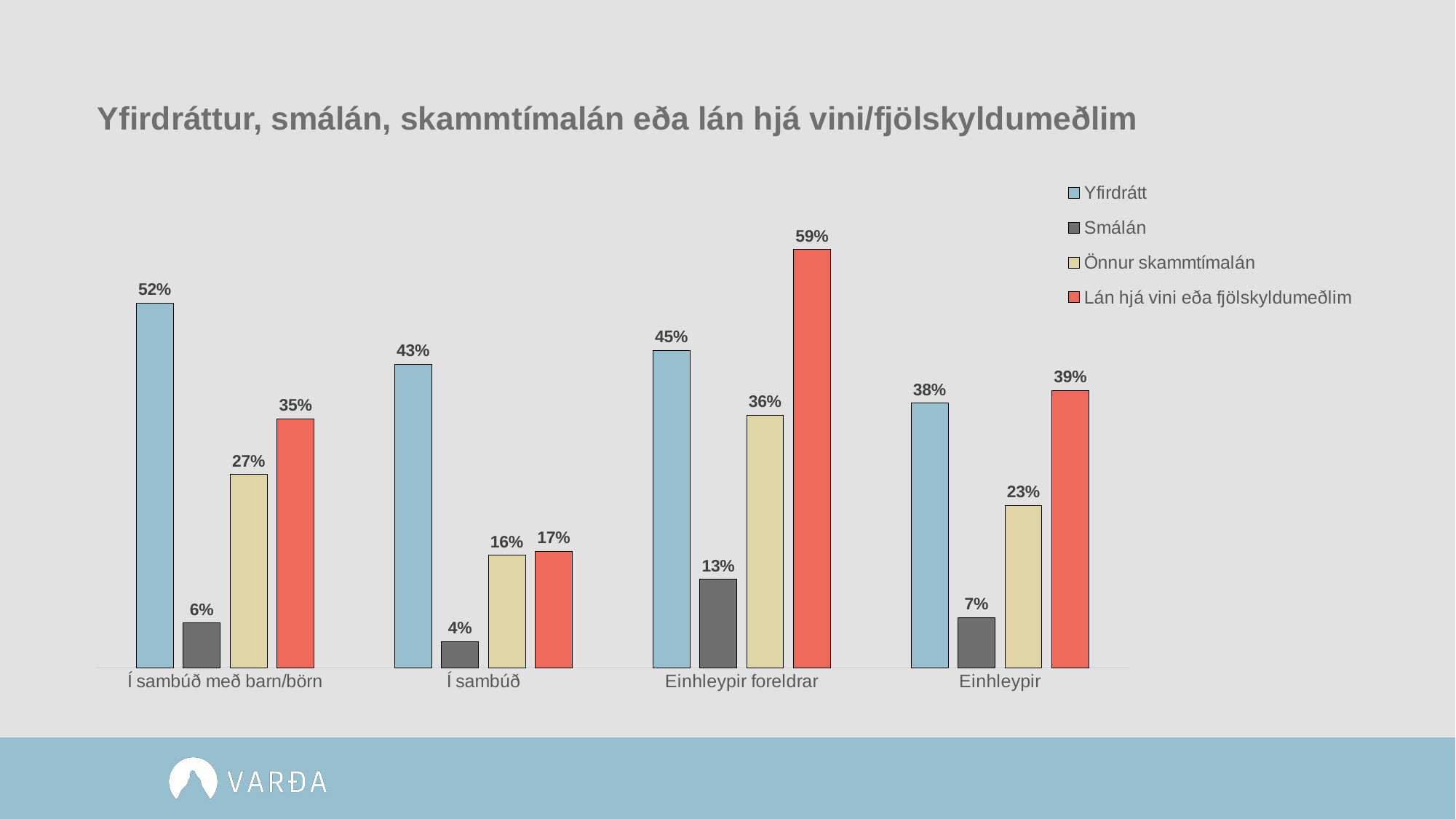
How many series does the legend list? 4 What is the value for Lán hjá vini eða fjölskyldumeðlim in the Einhleypir foreldrar category? 59% How many categories are shown on the x axis? 4 What is the value for Yfirdrátt in the Í sambúð með barn/börn category? 52% What is the value for Önnur skammtímalán in the Einhleypir category? 23% Which is larger in the Einhleypir category: Yfirdrátt or Lán hjá vini eða fjölskyldumeðlim? Lán hjá vini eða fjölskyldumeðlim What is the title of the chart? Yfirdráttur, smálán, skammtímalán eða lán hjá vini/fjölskyldumeðlim What is the value for Smálán in the Í sambúð category? 4% What kind of chart is shown on the slide? Bar chart What is the difference between the Lán hjá vini eða fjölskyldumeðlim value and the Yfirdrátt value in the Einhleypir foreldrar category? 14% Which category has the highest value for Yfirdrátt? Í sambúð með barn/börn Which category has the lowest value for Smálán? Í sambúð